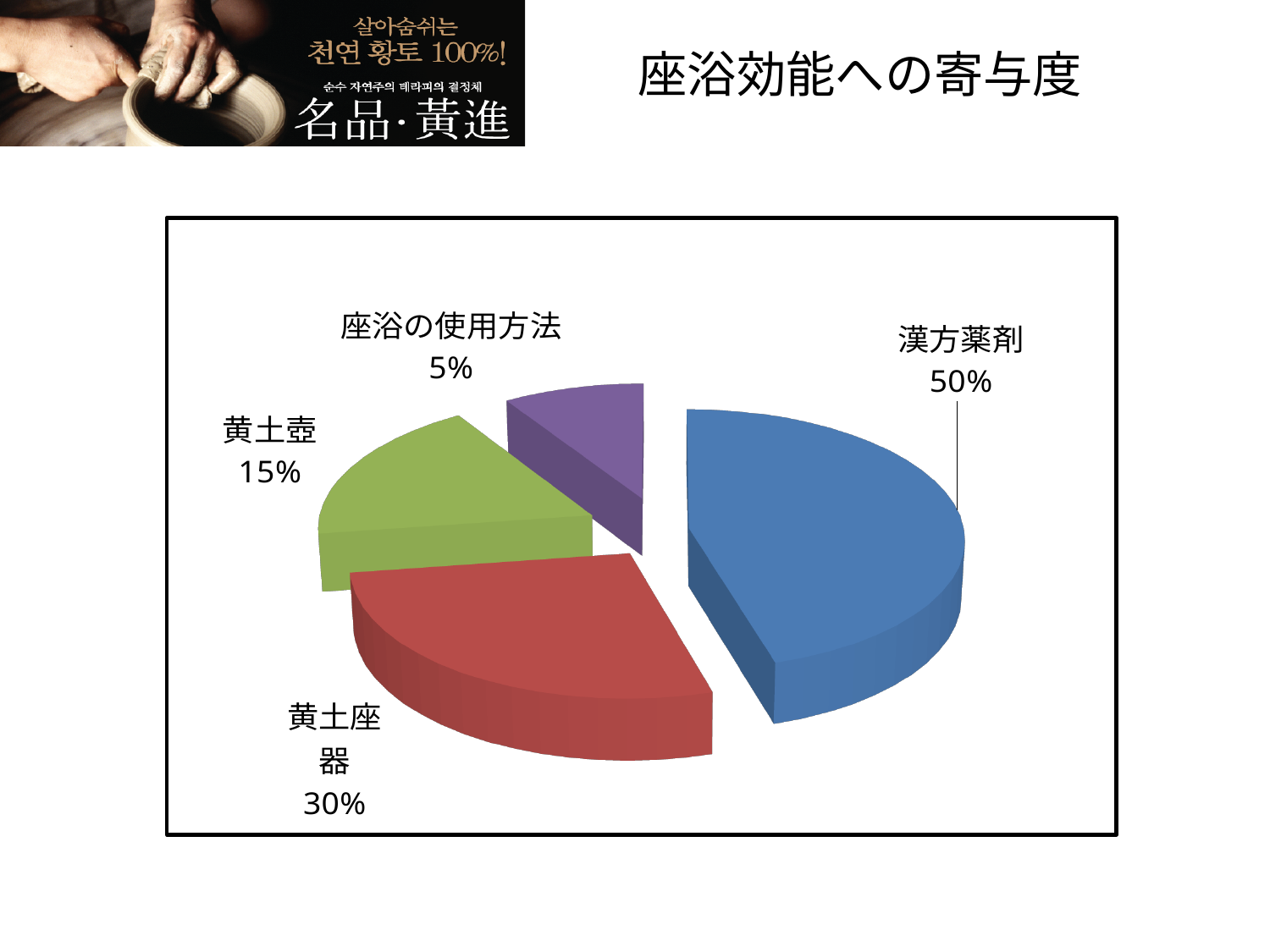
What percentage does 黄土座器 contribute in the pie chart? 30% What kind of chart is shown on the slide? Pie chart What percentage does 座浴の使用方法 contribute in the pie chart? 5% What is the title of the chart on the slide? 座浴効能への寄与度 Which category has the largest share of the pie chart? 漢方薬剤 What is the difference in percentage points between 黄土壺 and 座浴の使用方法? 10 What percentage does 漢方薬剤 contribute in the pie chart? 50% Which category has the smallest share of the pie chart? 座浴の使用方法 What is the difference in percentage points between 漢方薬剤 and 黄土座器? 20 Which is larger, the share for 黄土座器 or the share for 黄土壺? 黄土座器 How many slices does the pie chart have? 4 What percentage does 黄土壺 contribute in the pie chart? 15%